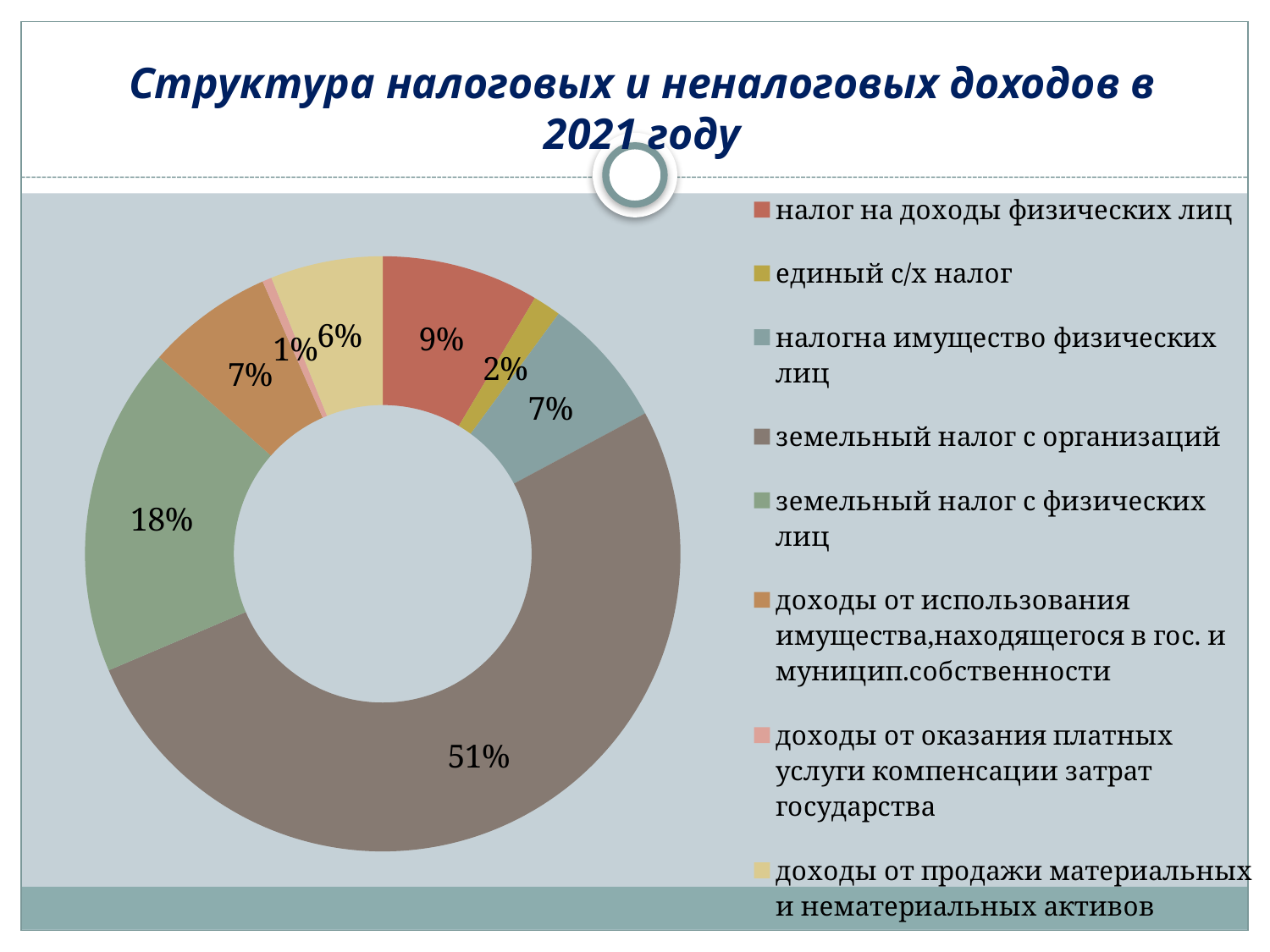
Which category has the smallest share of the chart? доходы от оказания платных услуги компенсации затрат государства What percentage is shown for 'налог на доходы физических лиц'? 9% What percentage is shown for 'земельный налог с физических лиц'? 18% What percentage is shown for 'доходы от продажи материальных и нематериальных активов'? 6% What is the title of the slide? Структура налоговых и неналоговых доходов в 2021 году How many categories does the chart show? 8 What percentage is shown for 'единый с/х налог'? 2% What share of the chart does 'земельный налог с организаций' account for? 51% What type of chart is shown on the slide? doughnut chart Which is larger: the share for 'налог на доходы физических лиц' or the share for 'доходы от продажи материальных и нематериальных активов'? налог на доходы физических лиц What is the difference in percentage points between 'земельный налог с организаций' and 'земельный налог с физических лиц'? 33 Which category has the largest share of the chart? земельный налог с организаций